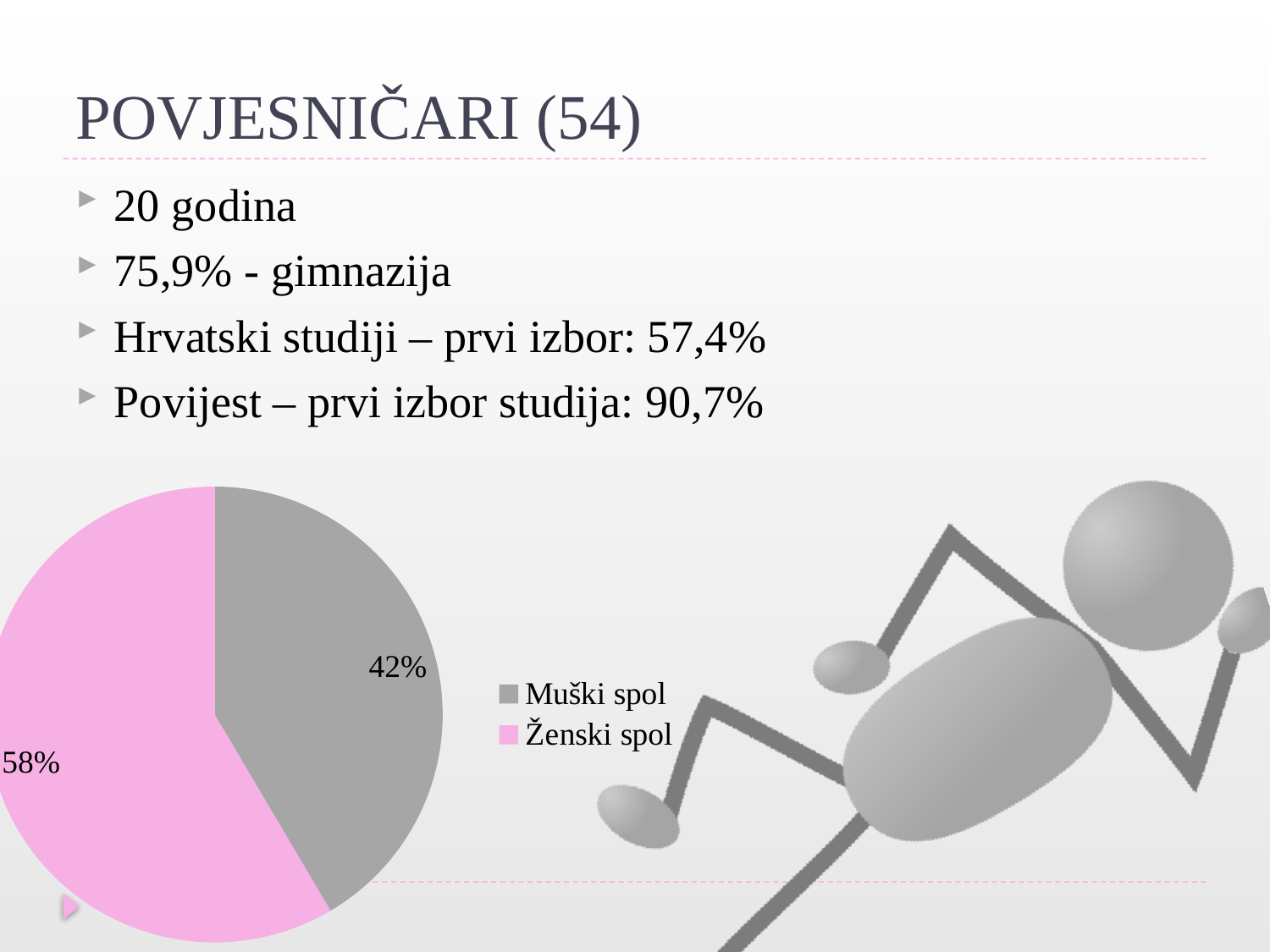
What share of the pie does Ženski spol have? 58% Which slice of the pie is the largest? Ženski spol What share of the pie does Muški spol have? 42% What colour is the Ženski spol slice? pink How many slices does the pie chart have? 2 What is the difference in percentage points between the Ženski spol and Muški spol slices? 16% Which is larger, the Muški spol slice or the Ženski spol slice? Ženski spol What colour is the Muški spol slice? grey Which slice of the pie is the smallest? Muški spol What kind of chart is shown on the slide? pie chart How many entries does the legend list? 2